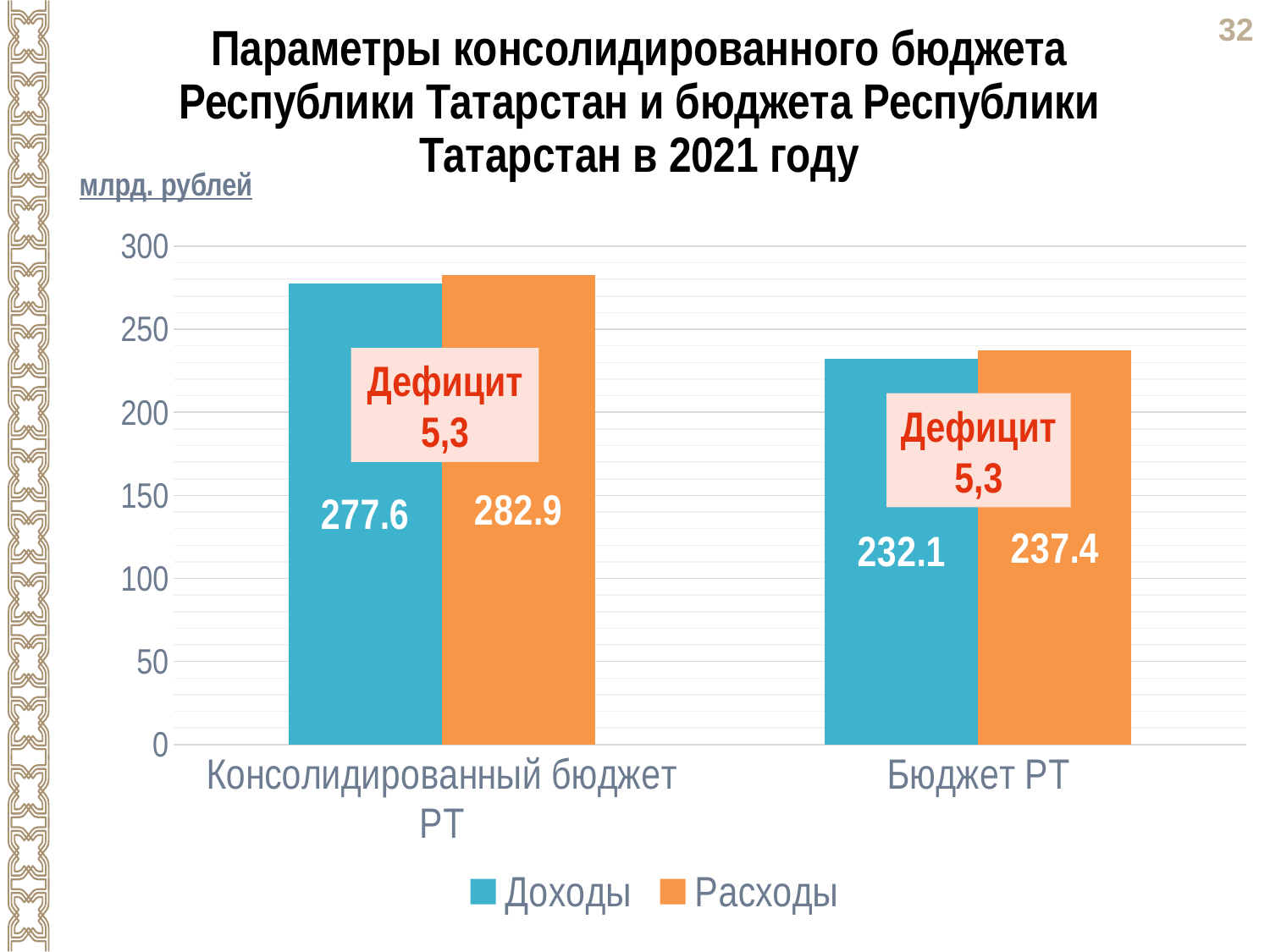
Which bar is the lowest on the chart? Доходы for Бюджет РТ How many categories are shown on the x axis? 2 What is the value of Доходы for Консолидированный бюджет РТ? 277.6 What is the difference between Доходы for Консолидированный бюджет РТ and Доходы for Бюджет РТ? 45.5 What kind of chart is shown on the slide? Bar chart How many series does the legend list? 2 What is the value of Расходы for Бюджет РТ? 237.4 Which bar is the highest on the chart? Расходы for Консолидированный бюджет РТ What is the value of Расходы for Консолидированный бюджет РТ? 282.9 What is the value of Доходы for Бюджет РТ? 232.1 What is the difference between Расходы and Доходы for Консолидированный бюджет РТ? 5.3 Which is larger for Бюджет РТ: Доходы or Расходы? Расходы